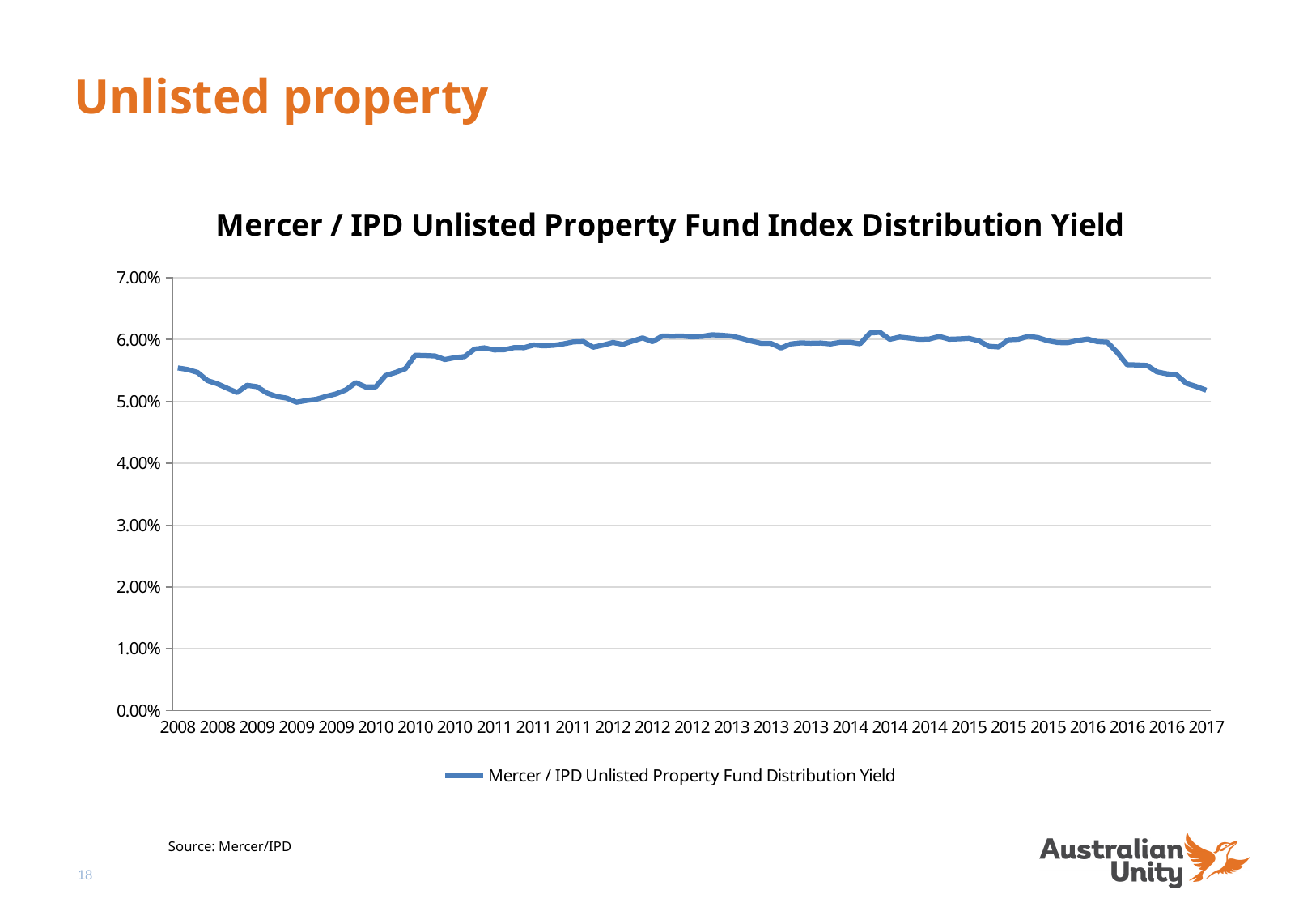
Does the line rise or fall between 2008 and 2009? fall Is the value at the last point (2017) greater or less than 6.00%? less What is the title of the chart? Mercer / IPD Unlisted Property Fund Index Distribution Yield Is the value at the first point (2008) greater or less than 5.00%? greater Does the line rise or fall between 2016 and 2017? fall Is the highest value on the line greater or less than 7.00%? less What kind of chart is shown on the slide? line chart How many series does the legend list? 1 What series name is shown in the legend? Mercer / IPD Unlisted Property Fund Distribution Yield Does the line rise or fall between 2009 and 2011? rise